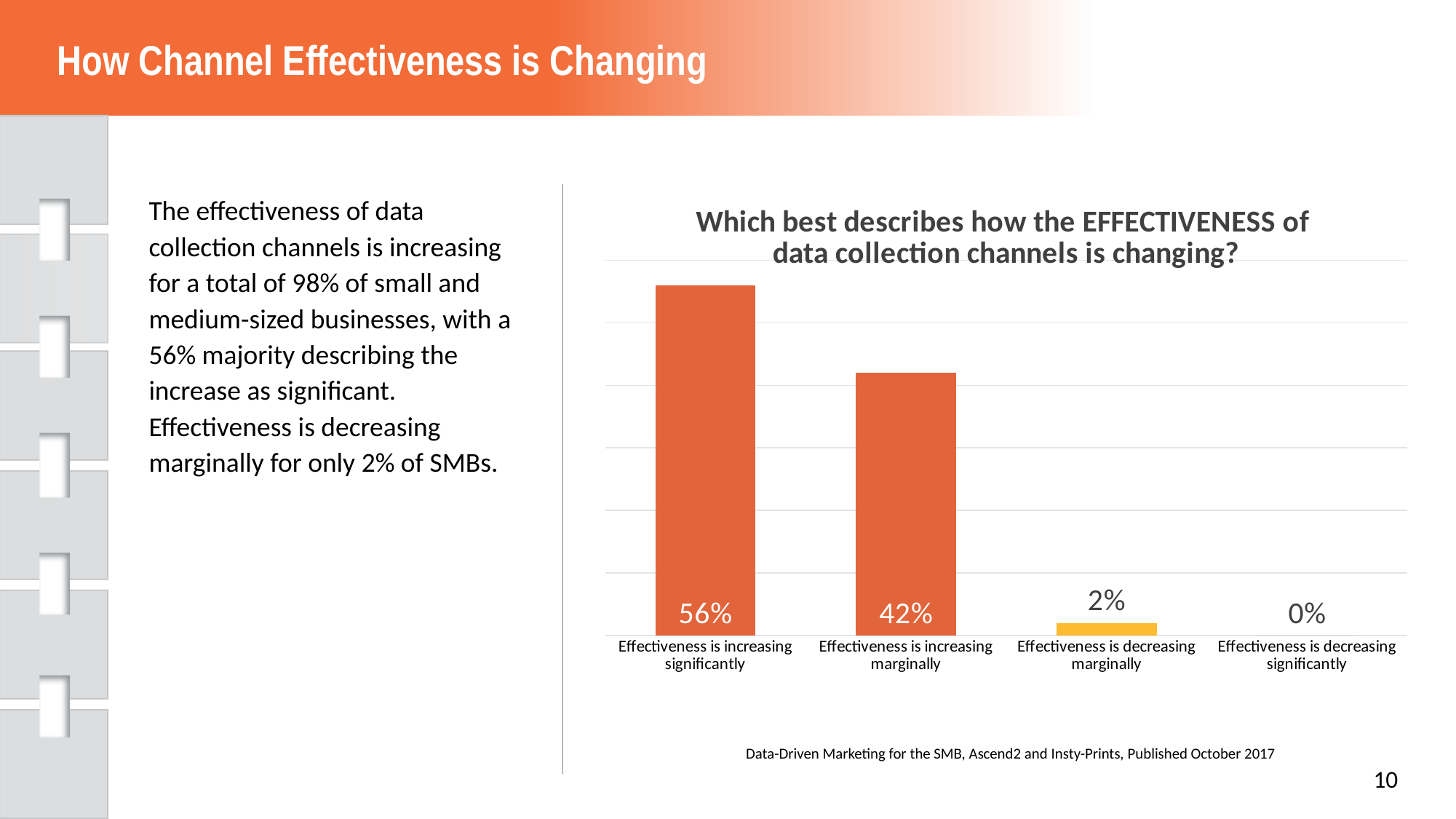
What value is shown for 'Effectiveness is decreasing marginally'? 2% Which category has the lowest value? Effectiveness is decreasing significantly How many categories are shown on the chart? 4 Which category has the highest value? Effectiveness is increasing significantly Do the values rise or fall from left to right across the categories? Fall What value is shown for 'Effectiveness is decreasing significantly'? 0% What kind of chart is shown on the slide? Bar chart What value is shown for 'Effectiveness is increasing marginally'? 42% What is the difference between 'Effectiveness is increasing significantly' and 'Effectiveness is increasing marginally'? 14% What is the title of the chart? Which best describes how the EFFECTIVENESS of data collection channels is changing? What percentage of respondents said effectiveness is increasing significantly? 56% Which is larger: 'Effectiveness is increasing marginally' or 'Effectiveness is decreasing marginally'? Effectiveness is increasing marginally